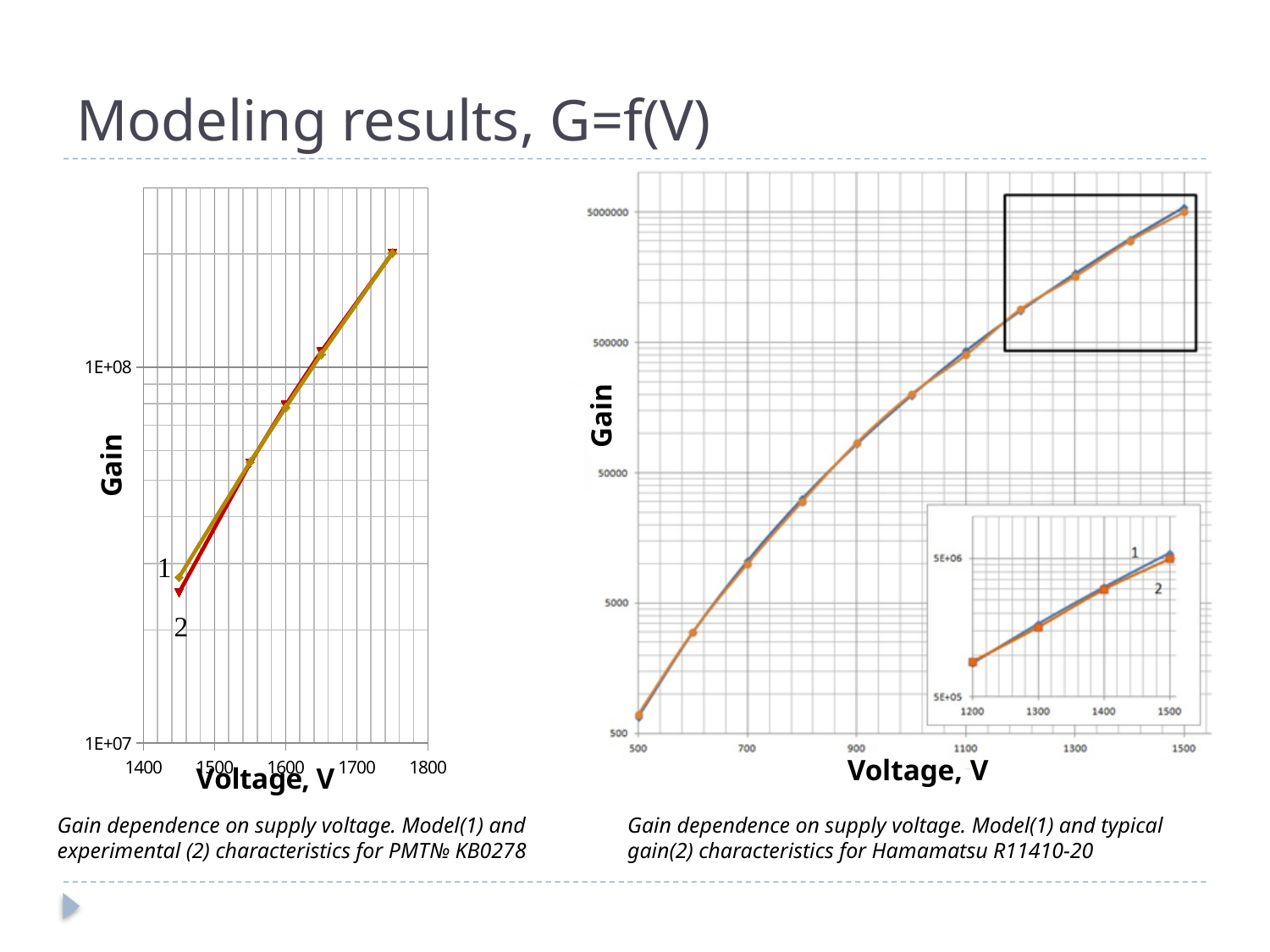
In the left chart (PMT№ KB0278), is the gain at 1450 V greater or less than 1E+08? less In the left chart (PMT№ KB0278), how many series are plotted? 2 In the left chart (PMT№ KB0278), is the gain at 1750 V greater or less than 1E+08? greater What kind of chart is the right chart (Hamamatsu R11410-20)? line chart In the right chart (Hamamatsu R11410-20), does the gain rise or fall as voltage increases? rise In the right chart (Hamamatsu R11410-20), how many series are plotted? 2 In the left chart (PMT№ KB0278), does the gain rise or fall as voltage increases? rise In the right chart (Hamamatsu R11410-20), is the gain at 700 V greater or less than 5000? greater What is the x-axis label on the left chart (PMT№ KB0278)? Voltage, V What kind of chart is the left chart (PMT№ KB0278)? line chart In the right chart (Hamamatsu R11410-20), how many data points are plotted along each curve? 11